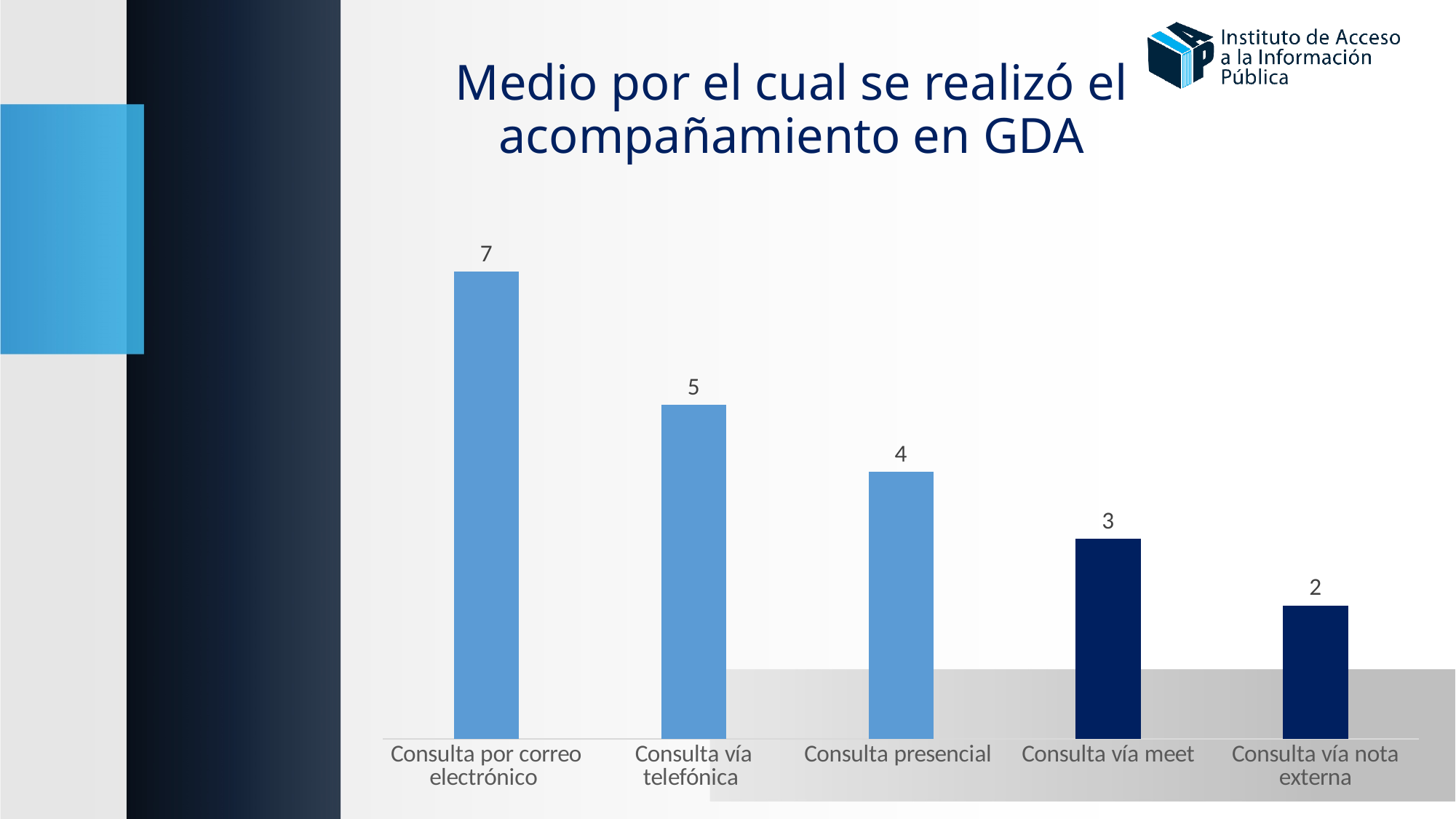
What is the value for Consulta presencial? 4 What is the value for Consulta vía telefónica? 5 How many categories are shown in the chart? 5 What kind of chart is shown on the slide? Bar chart What is the value for Consulta vía nota externa? 2 Which category has the lowest value? Consulta vía nota externa What is the difference between the values for Consulta por correo electrónico and Consulta vía telefónica? 2 Which category has the highest value? Consulta por correo electrónico What is the title of the chart? Medio por el cual se realizó el acompañamiento en GDA Which is larger, the value for Consulta presencial or the value for Consulta vía meet? Consulta presencial What is the value for Consulta por correo electrónico? 7 What is the value for Consulta vía meet? 3